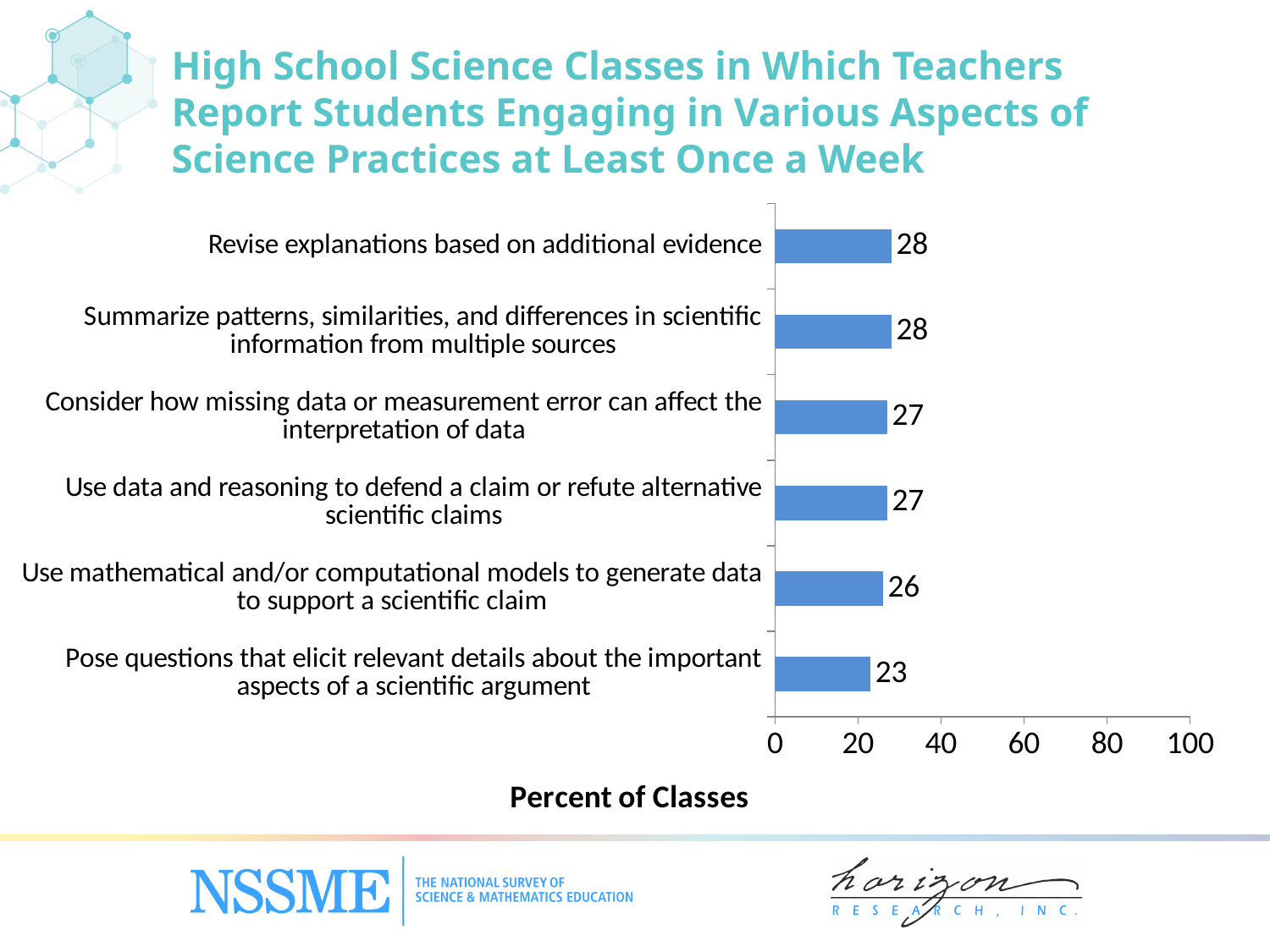
What is the difference between the values for "Revise explanations based on additional evidence" and "Pose questions that elicit relevant details about the important aspects of a scientific argument"? 5 Which category has the lowest percent of classes? Pose questions that elicit relevant details about the important aspects of a scientific argument What kind of chart is shown on the slide? Bar chart What is the label of the horizontal axis? Percent of Classes How many categories are shown in the chart? 6 What is the value for "Consider how missing data or measurement error can affect the interpretation of data"? 27 What percent of classes is reported for "Revise explanations based on additional evidence"? 28 Which is larger: the value for "Use data and reasoning to defend a claim or refute alternative scientific claims" or the value for "Pose questions that elicit relevant details about the important aspects of a scientific argument"? Use data and reasoning to defend a claim or refute alternative scientific claims What is the maximum value shown on the horizontal axis? 100 What is the value for "Pose questions that elicit relevant details about the important aspects of a scientific argument"? 23 What is the value for "Use mathematical and/or computational models to generate data to support a scientific claim"? 26 Is the value for "Summarize patterns, similarities, and differences in scientific information from multiple sources" greater or less than 40? less